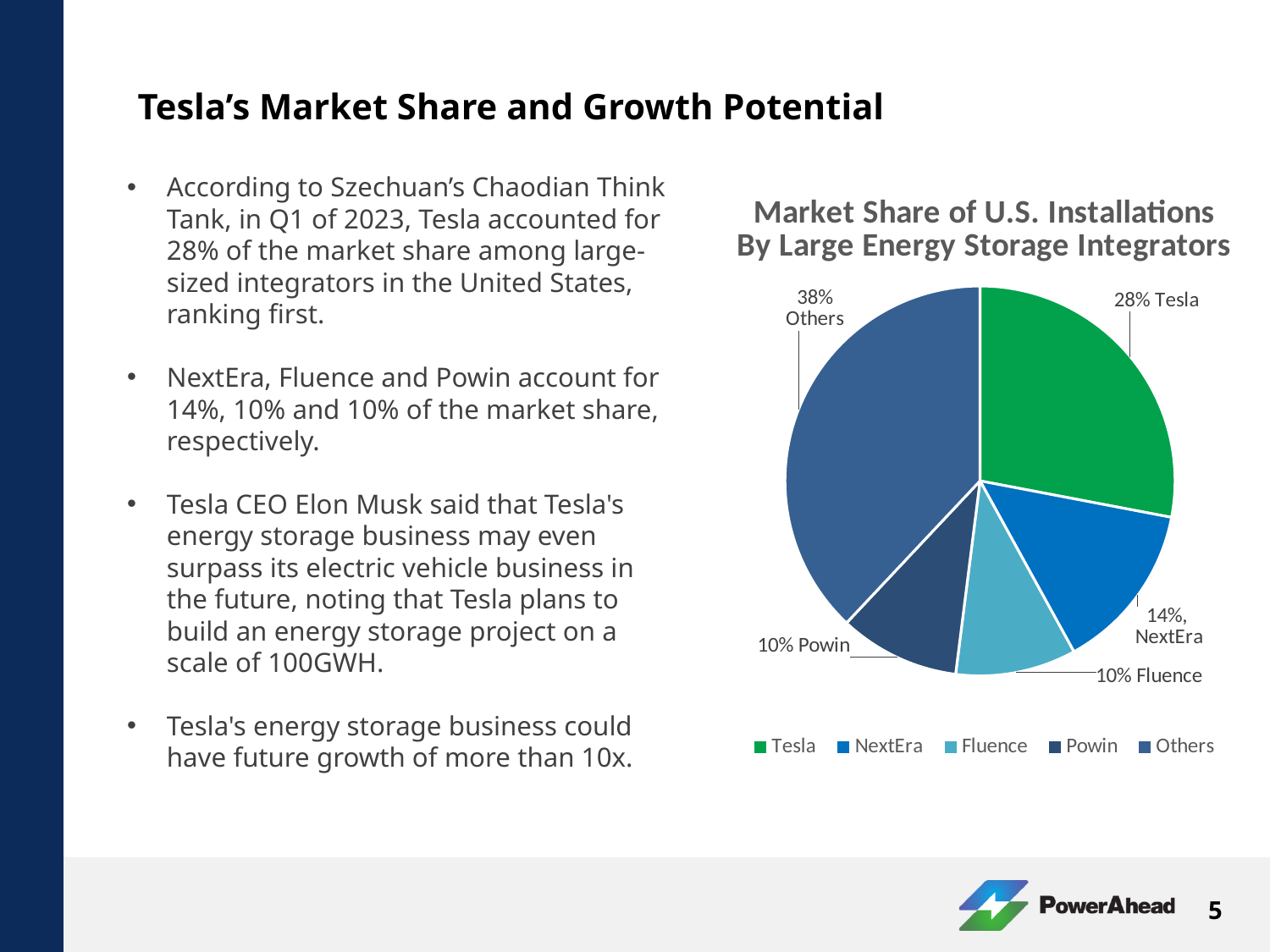
Which slice of the pie is the largest? Others What kind of chart is shown on the slide? Pie chart What is the difference in share between Tesla and NextEra? 14% What share of the pie does Fluence hold? 10% What share of the pie does NextEra hold? 14% What share of the pie does Others hold? 38% What is the title of the chart? Market Share of U.S. Installations By Large Energy Storage Integrators What is the combined share of Powin and Fluence? 20% Which named integrator (excluding Others) has the largest share? Tesla What share of the pie does Tesla hold? 28% How many slices does the pie chart have? 5 Which is larger, the share for Others or the share for Tesla? Others